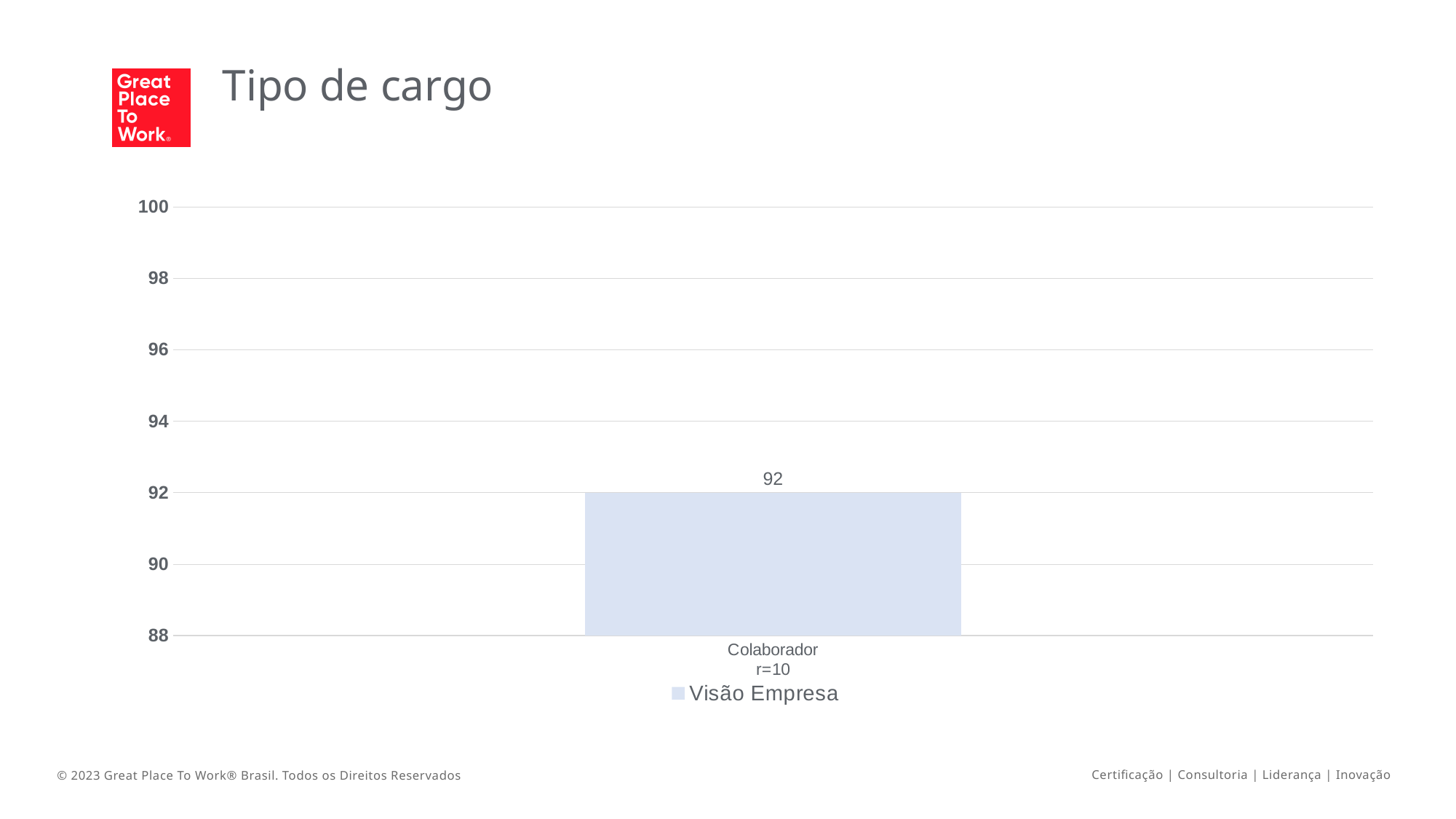
How many series does the legend list? 1 Is the value for Colaborador greater or less than 94? less What kind of chart is shown on the slide? bar chart Is the value for Colaborador greater or less than 90? greater What is the value for Colaborador? 92 How many categories are shown on the x axis? 1 What is the highest value shown on the y axis? 100 What is the title of the slide? Tipo de cargo What is the lowest value shown on the y axis? 88 What series name is listed in the legend? Visão Empresa What is the r value shown under the Colaborador category label? r=10